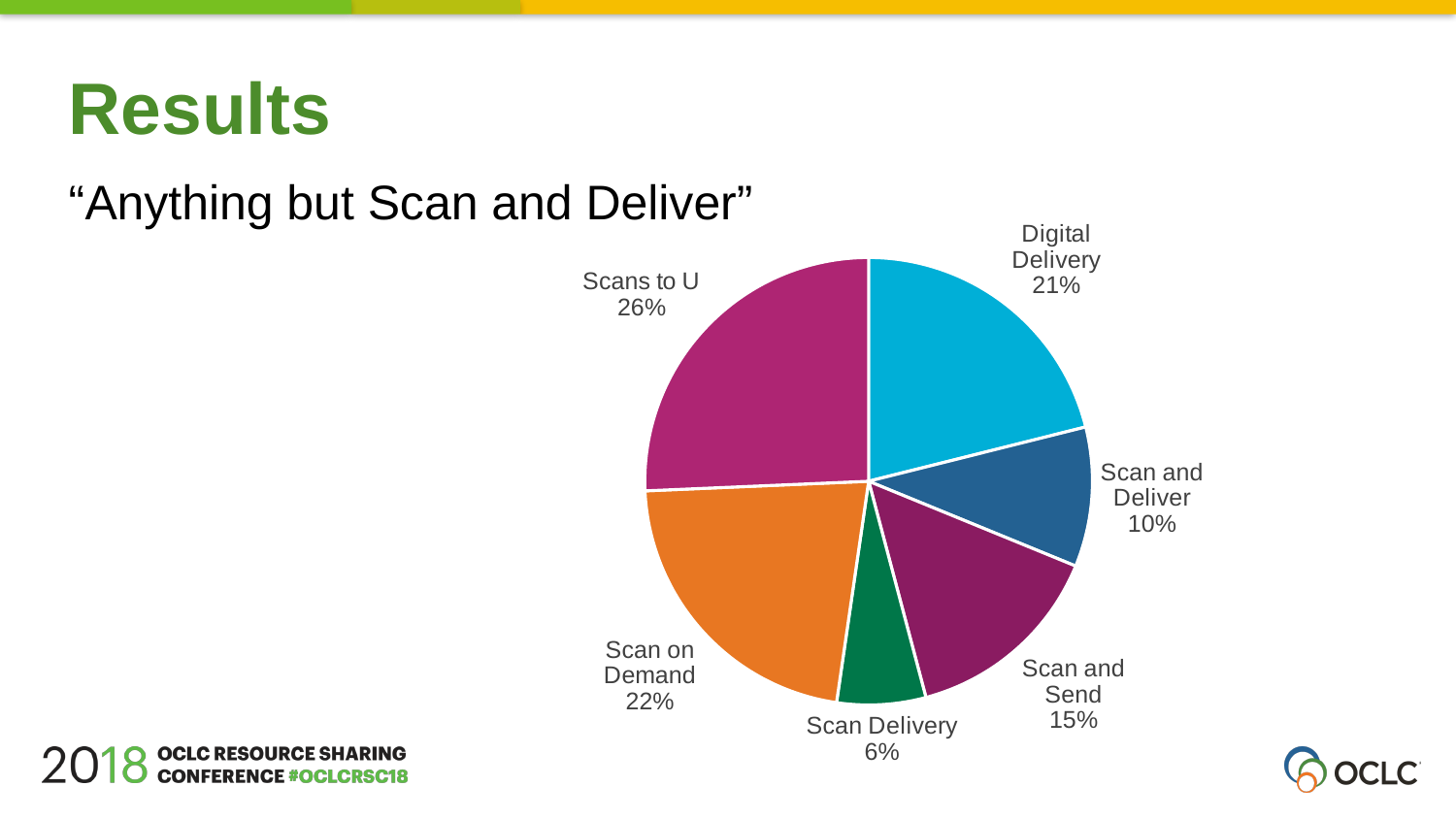
What kind of chart is shown on the slide? pie chart What is the quoted text shown above the chart? "Anything but Scan and Deliver" What share of the pie does Scans to U have? 26% Which category has the largest slice of the pie? Scans to U What percentage is shown for Scan Delivery? 6% Which category has the smallest slice of the pie? Scan Delivery What is the combined percentage of Scan and Deliver and Scan and Send? 25% How many slices does the pie chart have? 6 Which is larger, Digital Delivery or Scan and Deliver? Digital Delivery What percentage is shown for Scan and Deliver? 10% What is the difference in percentage points between Scan on Demand and Scan and Send? 7 What percentage is shown for Digital Delivery? 21%